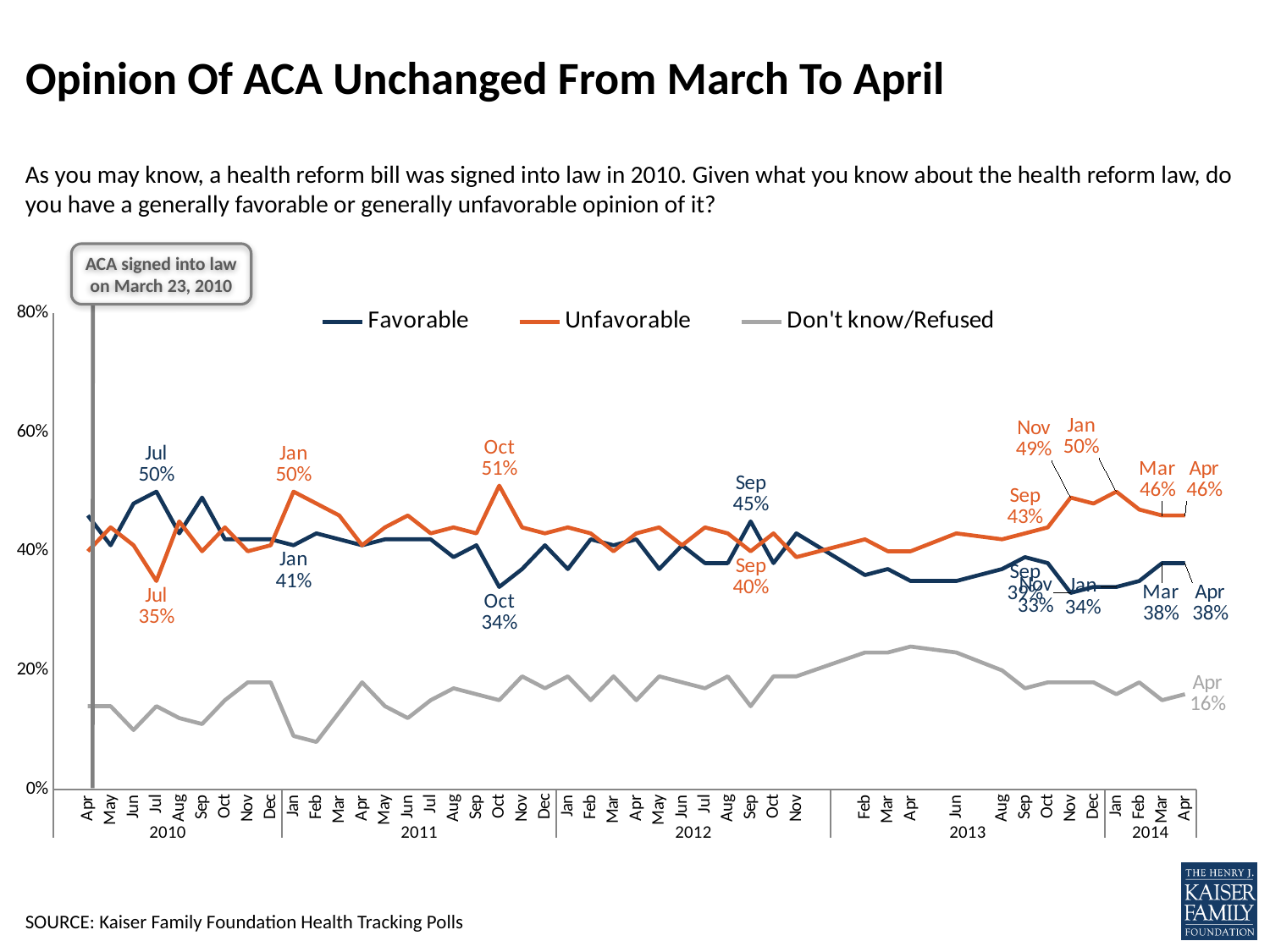
What was the Favorable value in July 2010? 50% Is the Don't know/Refused value in April 2013 greater or less than 20%? greater What was the Don't know/Refused value in April 2014? 16% What is the difference between the Unfavorable and Favorable values in April 2014? 8 percentage points What was the Unfavorable value in October 2011? 51% What kind of chart is shown on the slide? Line chart What was the Favorable value in April 2014? 38% In September 2012, which was larger, Favorable or Unfavorable? Favorable How many series does the legend list? 3 Did the Favorable value rise or fall from November 2013 to March 2014? Rise What is the difference between the Unfavorable value in January 2014 and in March 2014? 4 percentage points According to the annotation box, on what date was the ACA signed into law? March 23, 2010